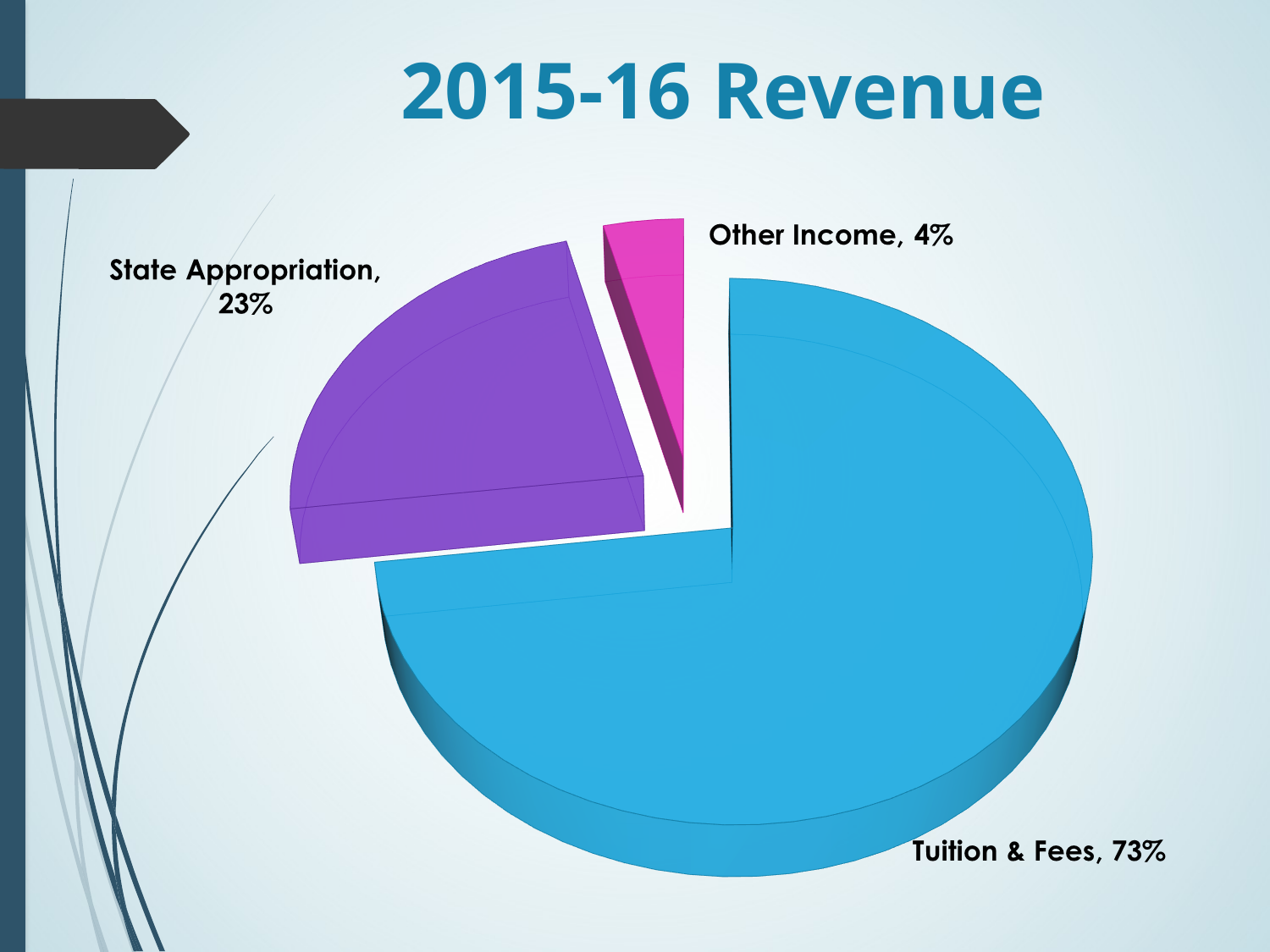
Which revenue source has the largest share of the pie? Tuition & Fees What colour is the Tuition & Fees slice? Blue What share of 2015-16 revenue comes from Other Income? 4% How many slices does the pie chart have? 3 How many percentage points larger is State Appropriation than Other Income? 19 Which is larger, State Appropriation or Other Income? State Appropriation Which revenue source has the smallest share of the pie? Other Income What share of 2015-16 revenue comes from Tuition & Fees? 73% What share of 2015-16 revenue comes from State Appropriation? 23% What is the title of the chart? 2015-16 Revenue What kind of chart is shown on the slide? Pie chart How many percentage points larger is Tuition & Fees than State Appropriation? 50